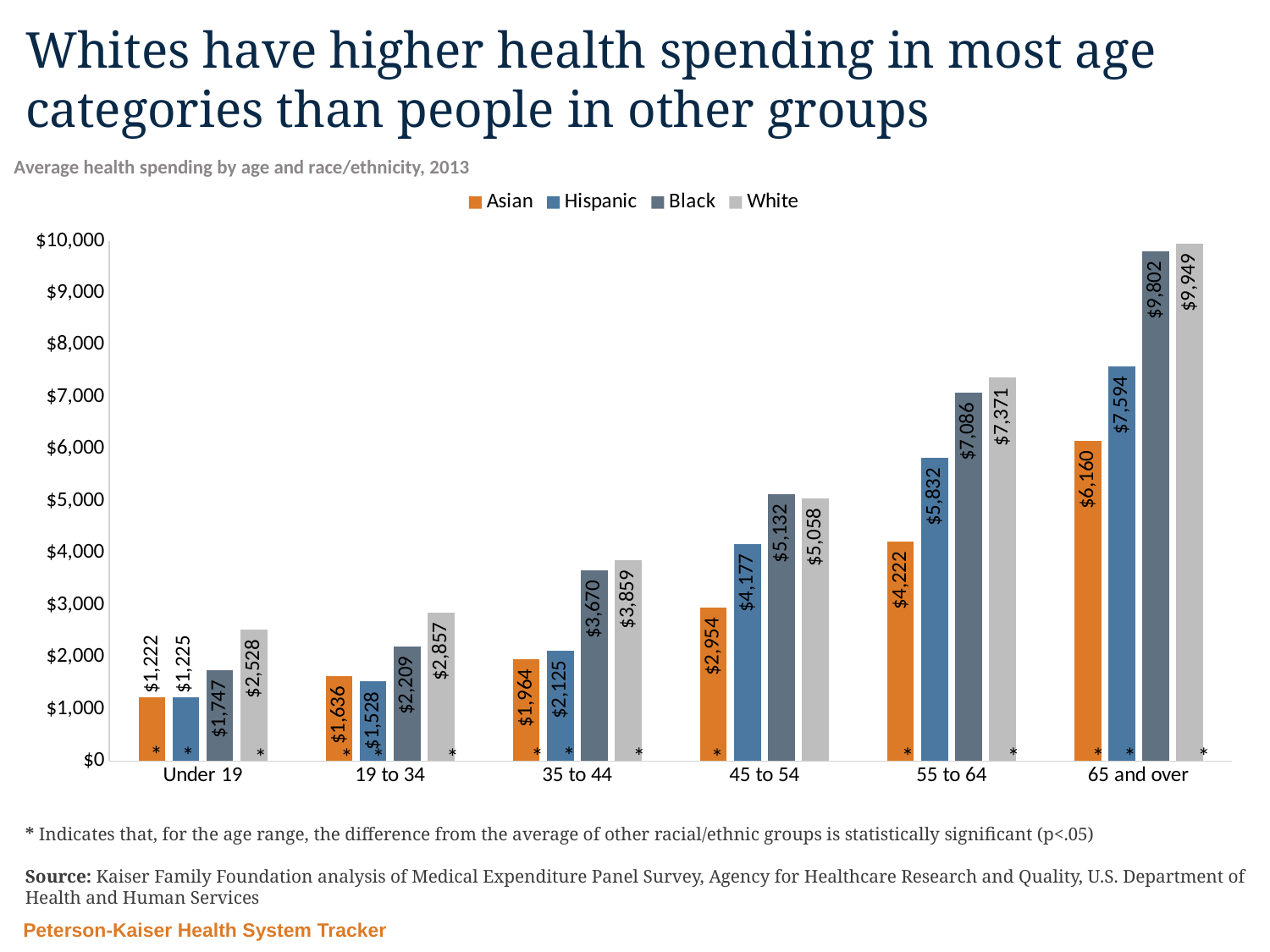
Is the value for Black people aged 55 to 64 greater or less than $7,000? greater How many age categories are shown on the x axis? 6 What is the average health spending for Hispanic people in the 19 to 34 age group? $1,528 In the 19 to 34 age group, which is larger: the Asian value or the Hispanic value? Asian Which racial/ethnic group has the highest average health spending in the 45 to 54 age group? Black What kind of chart is shown on the slide? Bar chart What is the difference between White and Asian average health spending in the 35 to 44 age group? $1,895 Do the White values rise or fall as age increases along the x axis? Rise What is the average health spending for Asian people in the 45 to 54 age group? $2,954 Which racial/ethnic group has the lowest average health spending in the 55 to 64 age group? Asian What is the average health spending for White people aged 65 and over? $9,949 How many series does the legend list? 4